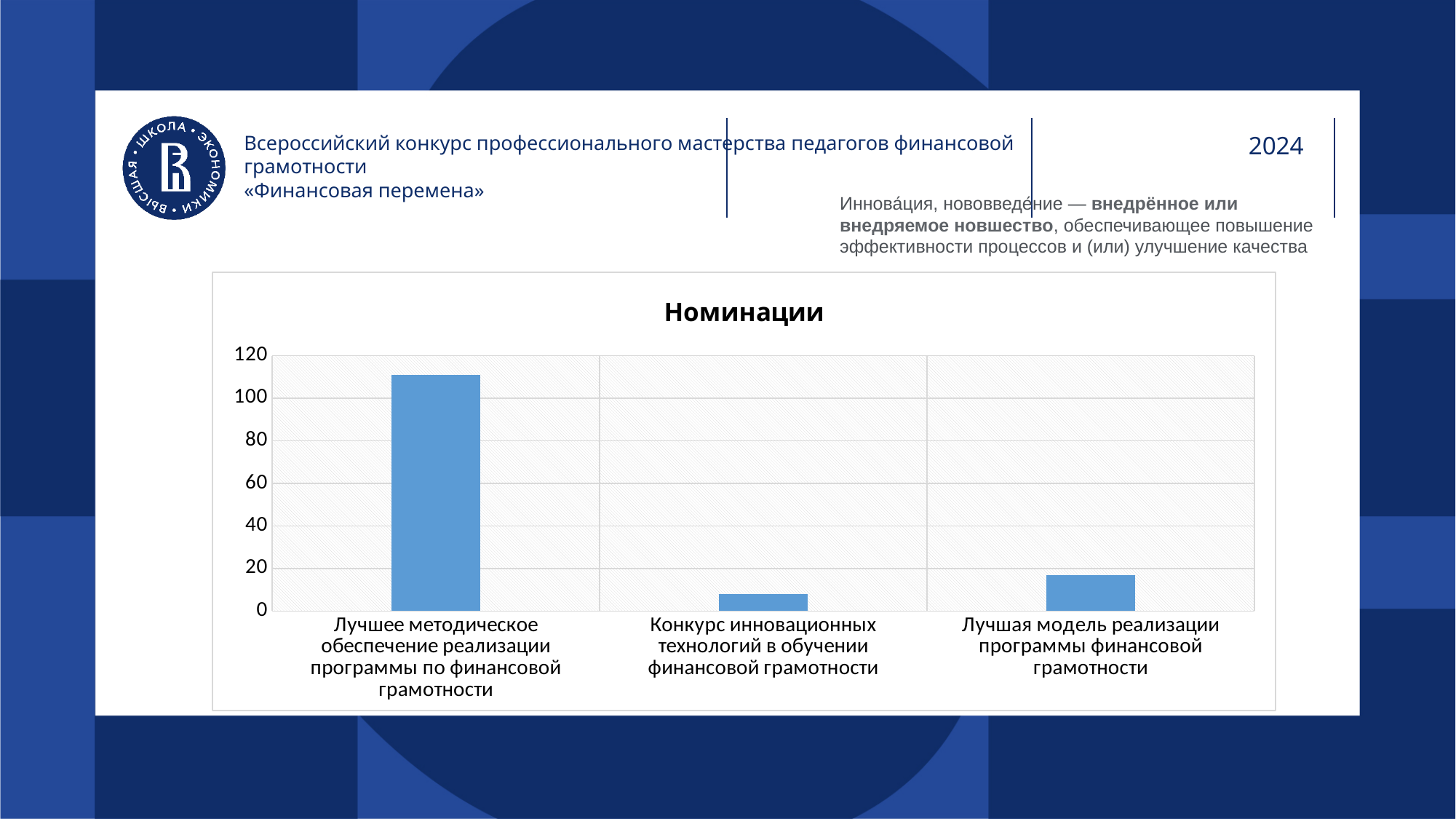
What is the highest tick value shown on the vertical axis of the chart? 120 How many categories are shown on the x axis of the chart? 3 What kind of chart is shown on the slide? bar chart Which category has the highest value? Лучшее методическое обеспечение реализации программы по финансовой грамотности Is the value for «Конкурс инновационных технологий в обучении финансовой грамотности» greater or less than 20? less Which is larger: the value for «Лучшая модель реализации программы финансовой грамотности» or the value for «Конкурс инновационных технологий в обучении финансовой грамотности»? Лучшая модель реализации программы финансовой грамотности Is the value for «Лучшее методическое обеспечение реализации программы по финансовой грамотности» greater or less than 120? less Is the value for «Лучшее методическое обеспечение реализации программы по финансовой грамотности» greater or less than 100? greater What is the title of the chart? Номинации Which category has the lowest value? Конкурс инновационных технологий в обучении финансовой грамотности